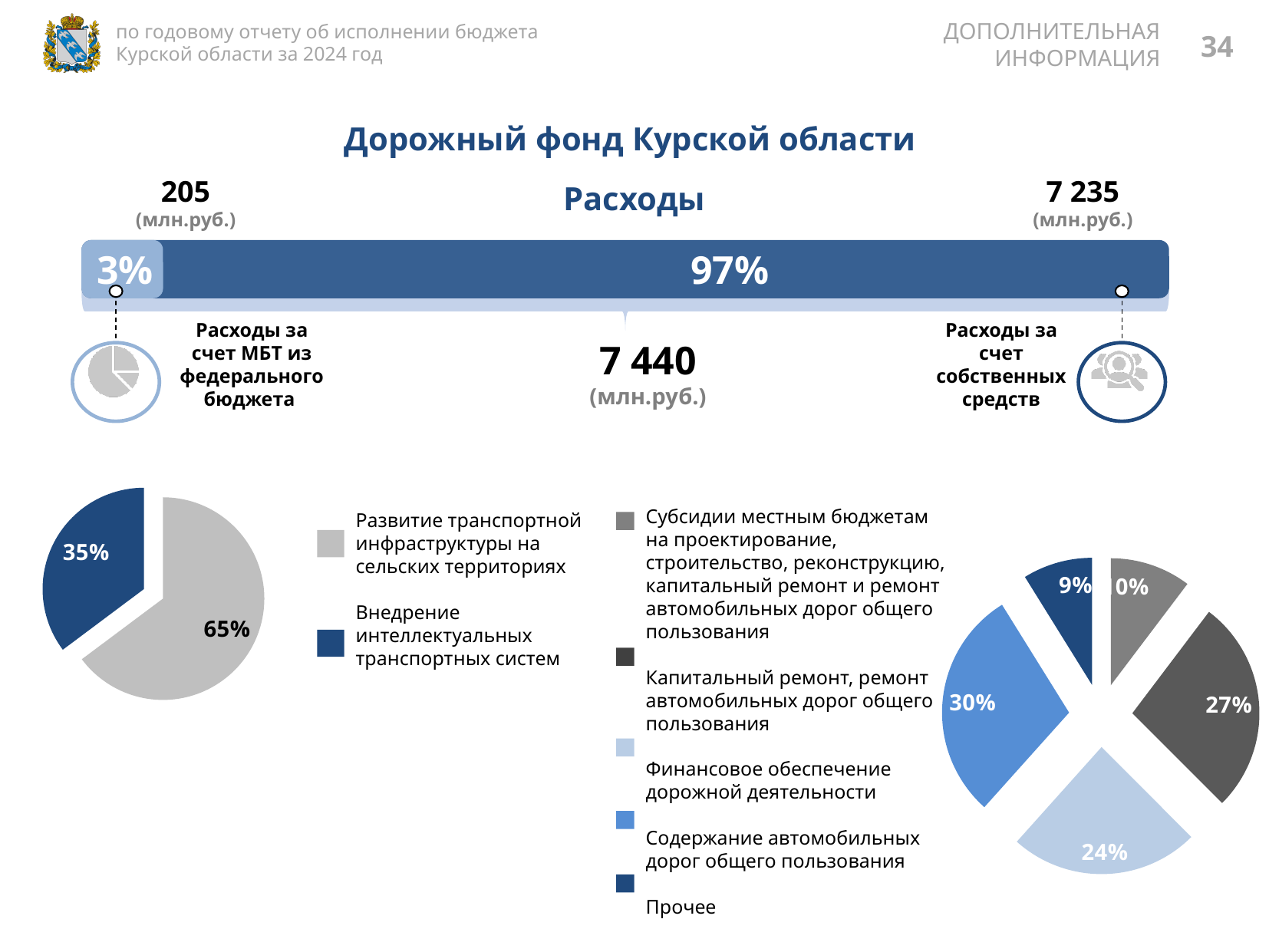
In the right pie chart, which is larger: 'Содержание автомобильных дорог общего пользования' or 'Финансовое обеспечение дорожной деятельности'? Содержание автомобильных дорог общего пользования What type of chart is the left chart on the slide? pie chart How many slices does the right pie chart have? 5 In the right pie chart, what share is shown for 'Прочее'? 9% In the left pie chart, what share is shown for 'Развитие транспортной инфраструктуры на сельских территориях'? 65% In the right pie chart, what share is shown for 'Содержание автомобильных дорог общего пользования'? 30% In the top 'Расходы' bar, what percentage is shown for 'Расходы за счет собственных средств'? 97% In the left pie chart, which category has the largest slice? Развитие транспортной инфраструктуры на сельских территориях In the left pie chart, what is the difference between the two slices? 30%